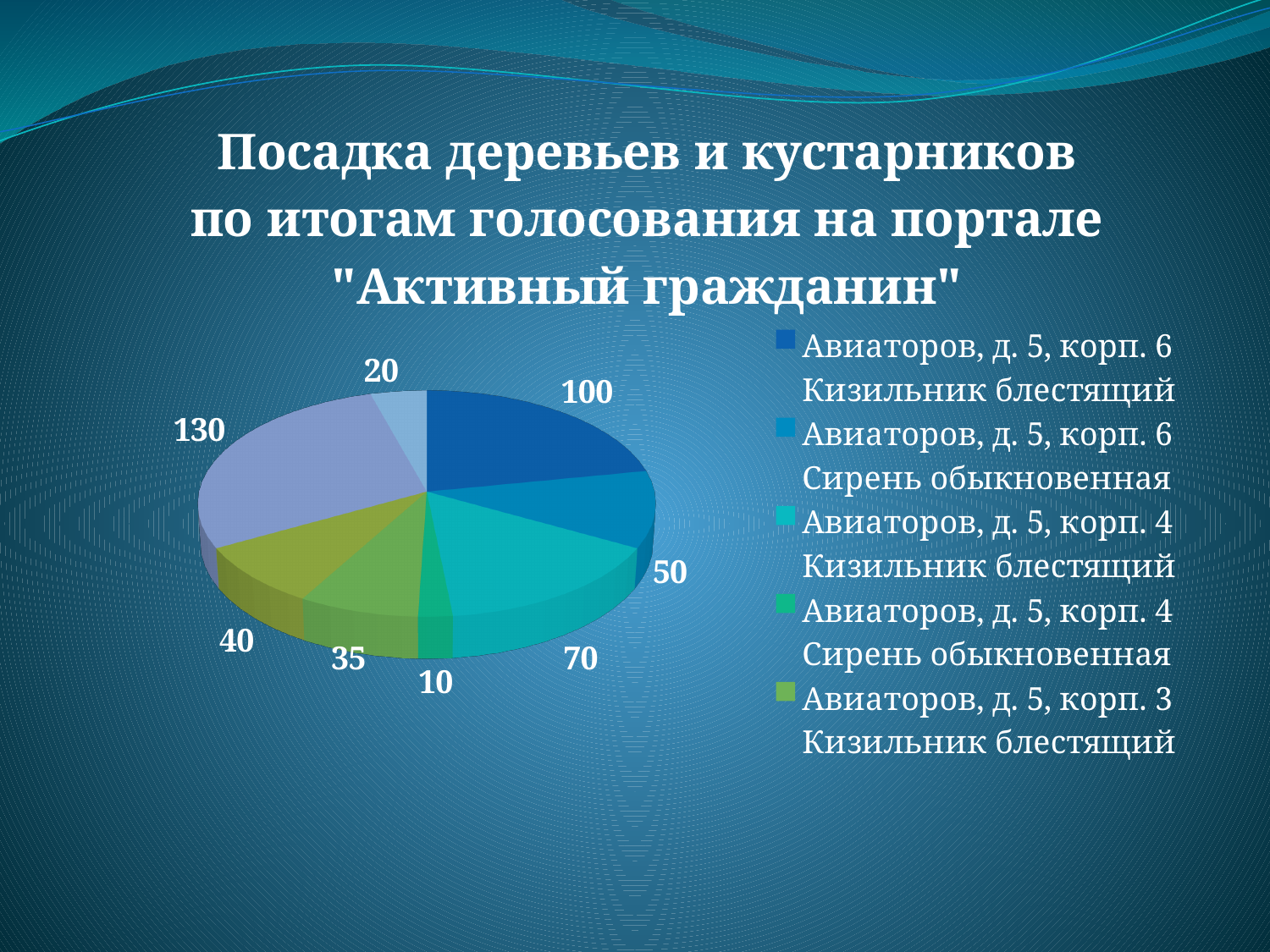
What is the difference between the values for Авиаторов, д. 5, корп. 6 Кизильник блестящий and Авиаторов, д. 5, корп. 6 Сирень обыкновенная? 50 What is the value for Авиаторов, д. 5, корп. 6 Сирень обыкновенная? 50 What is the value for Авиаторов, д. 5, корп. 3 Кизильник блестящий? 35 What is the value for Авиаторов, д. 5, корп. 4 Сирень обыкновенная? 10 What is the largest value shown on the pie chart? 130 How many slices does the pie chart have? 8 What is the smallest value shown on the pie chart? 10 Which has the larger value: Авиаторов, д. 5, корп. 6 Кизильник блестящий or Авиаторов, д. 5, корп. 4 Кизильник блестящий? Авиаторов, д. 5, корп. 6 Кизильник блестящий What kind of chart is shown on the slide? pie chart What is the value for Авиаторов, д. 5, корп. 4 Кизильник блестящий? 70 How many entries are visible in the chart's legend? 5 What is the value for Авиаторов, д. 5, корп. 6 Кизильник блестящий? 100